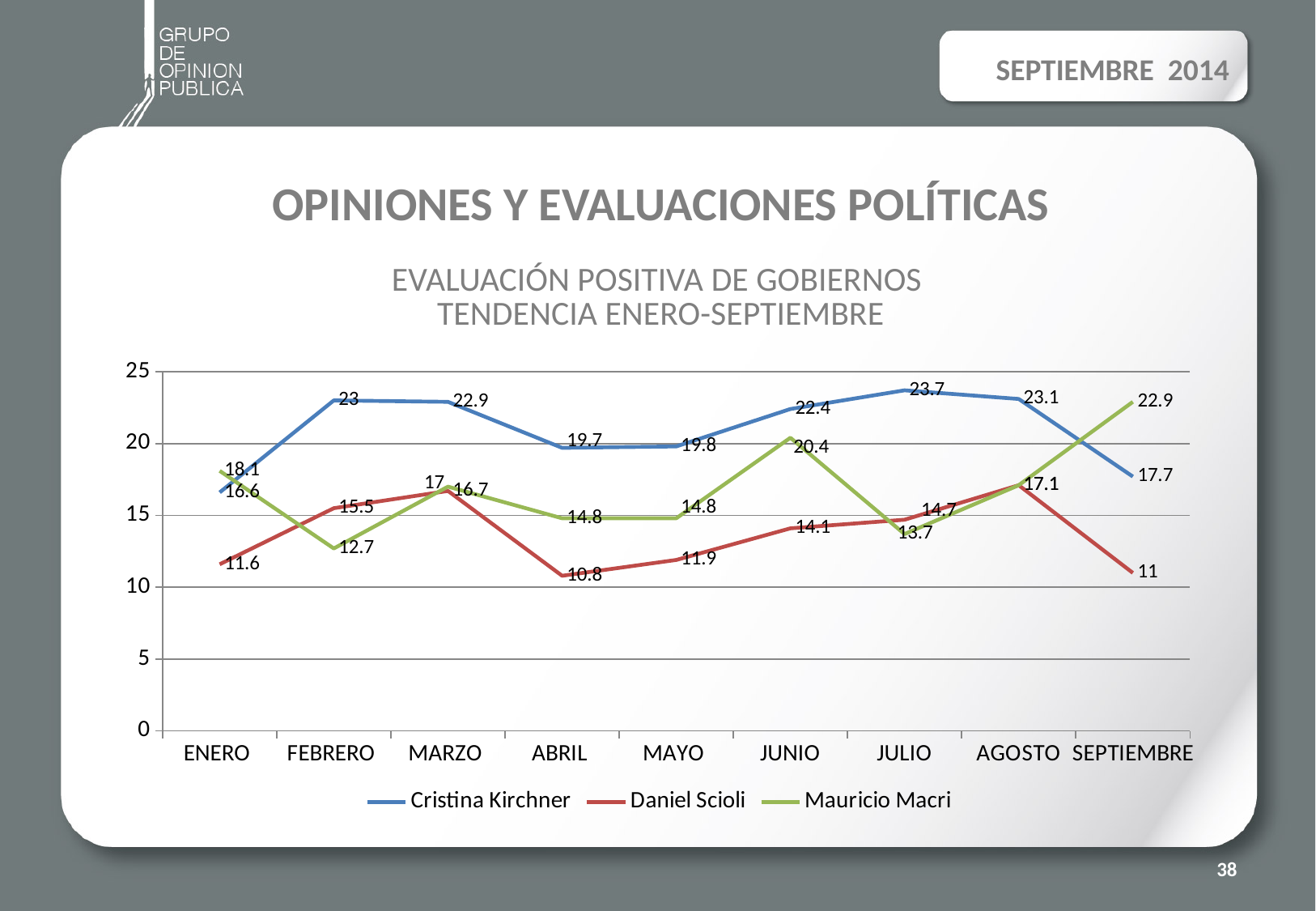
How many months are plotted along the x axis? 9 What colour is the line for Mauricio Macri? Green Does Cristina Kirchner's value rise or fall from AGOSTO to SEPTIEMBRE? Fall What is the value for Mauricio Macri in SEPTIEMBRE? 22.9 In which month does Daniel Scioli have his lowest value? ABRIL What is the value for Cristina Kirchner in JULIO? 23.7 What is the value for Daniel Scioli in ABRIL? 10.8 What kind of chart is shown on the slide? Line chart What is the difference between Mauricio Macri's and Cristina Kirchner's values in SEPTIEMBRE? 5.2 In which month does Cristina Kirchner reach her highest value? JULIO In JUNIO, who has the higher value, Mauricio Macri or Daniel Scioli? Mauricio Macri How many series does the legend list? 3